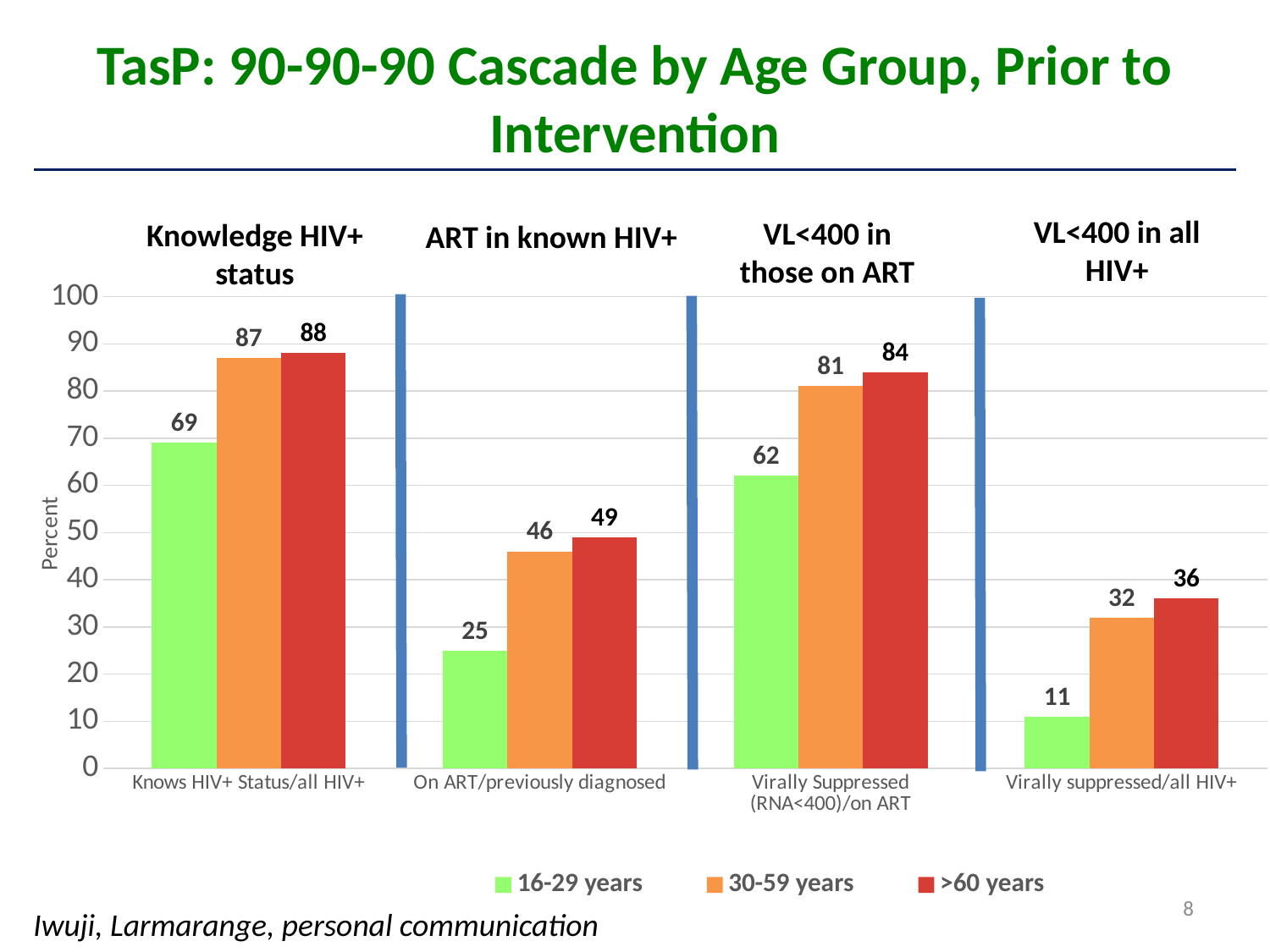
Which is larger: the 30-59 years value for Knows HIV+ Status/all HIV+ or the 30-59 years value for Virally Suppressed (RNA<400)/on ART? Knows HIV+ Status/all HIV+ How many categories are shown on the x axis? 4 What is the value for the >60 years group in the On ART/previously diagnosed category? 49 What is the difference between the >60 years and 16-29 years values in the On ART/previously diagnosed category? 24 What is the value for the 16-29 years group in the Virally suppressed/all HIV+ category? 11 Which age group has the lowest value in the Virally suppressed/all HIV+ category? 16-29 years What is the value for the 30-59 years group in the Virally Suppressed (RNA<400)/on ART category? 81 What is the label of the y axis? Percent How many series does the legend list? 3 What kind of chart is shown on the slide? Bar chart Which age group has the highest value in the Knows HIV+ Status/all HIV+ category? >60 years What is the value for the 16-29 years group in the Knows HIV+ Status/all HIV+ category? 69